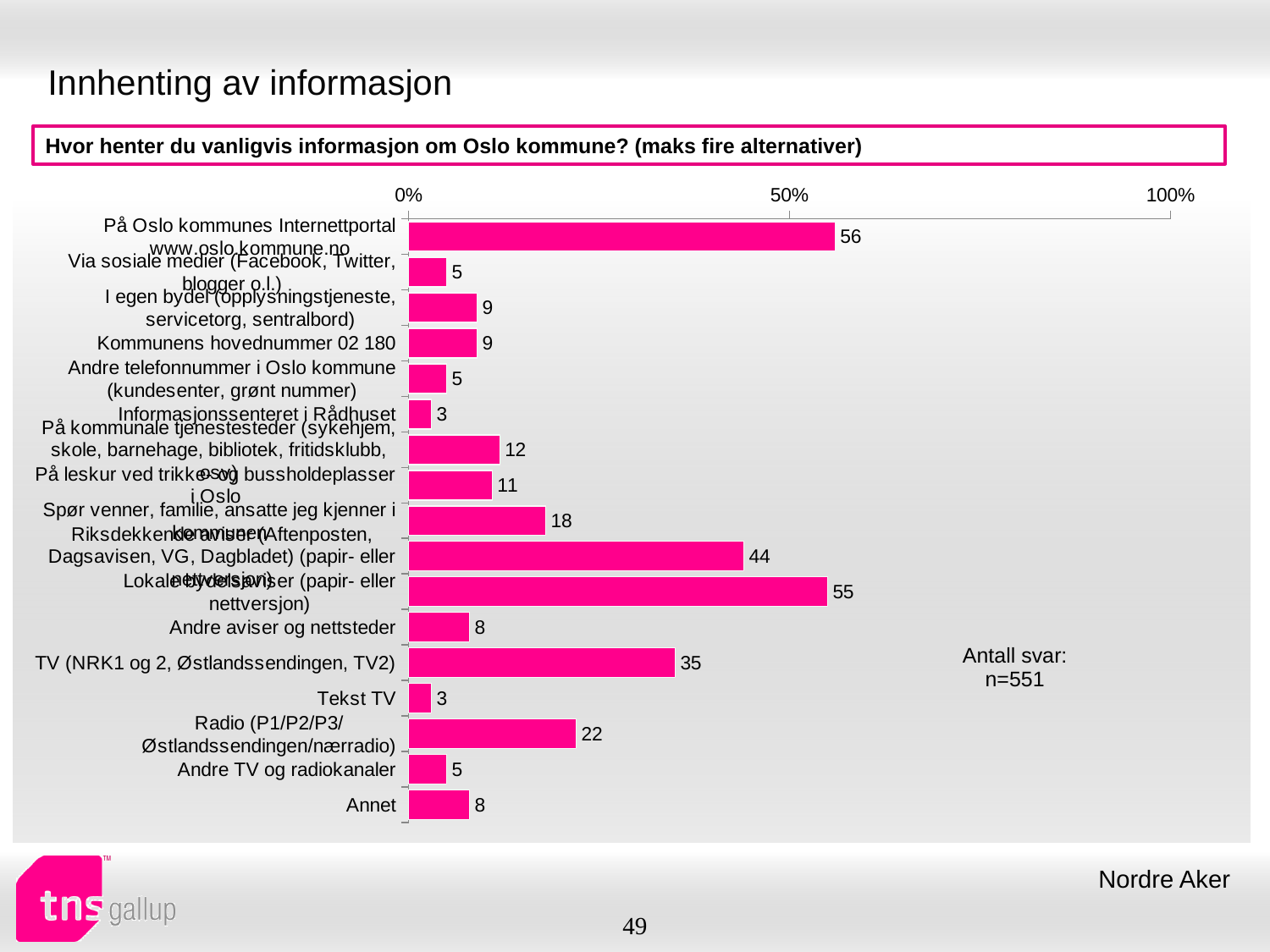
What kind of chart is shown on the slide? bar chart How many categories are shown in the chart? 17 Is the value for "TV (NRK1 og 2, Østlandssendingen, TV2)" greater or less than 50%? less Which is larger, the value for "Andre TV og radiokanaler" or the value for "Annet"? Annet What is the value for "Radio (P1/P2/P3/ Østlandssendingen/nærradio)"? 22 What is the value for "TV (NRK1 og 2, Østlandssendingen, TV2)"? 35 What is the number of respondents (Antall svar) stated on the slide? n=551 Which category has the highest value? På Oslo kommunes Internettportal www.oslo.kommune.no What is the value for "Tekst TV"? 3 What is the value for "Kommunens hovednummer 02 180"? 9 What is the value for "Annet"? 8 What is the difference between the values for "TV (NRK1 og 2, Østlandssendingen, TV2)" and "Radio (P1/P2/P3/ Østlandssendingen/nærradio)"? 13